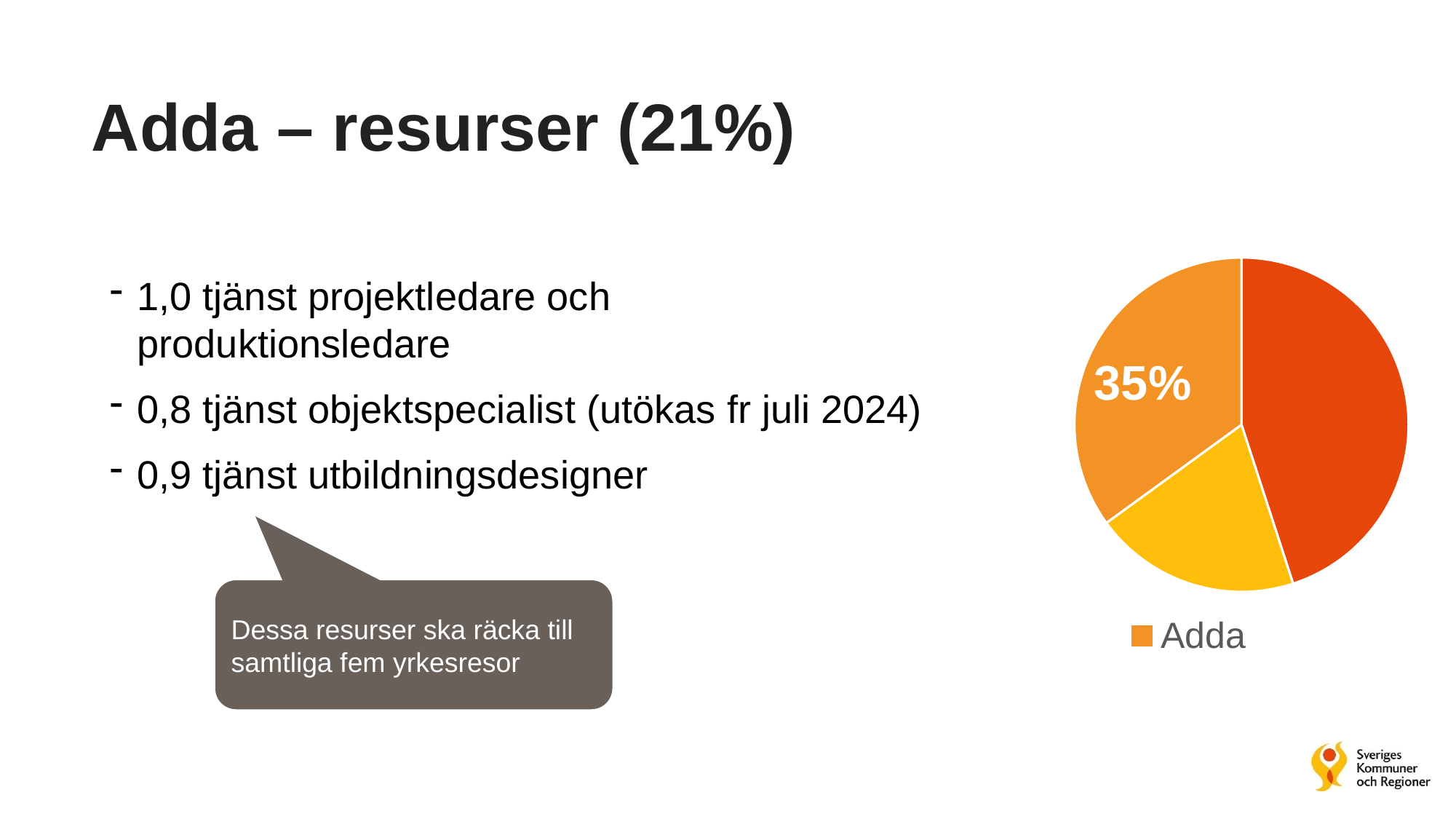
What is the only entry shown in the pie chart's legend? Adda What share of the pie does the Adda slice represent? 35% Is the red slice of the pie chart larger or smaller than the Adda slice? larger What percentage is printed on the Adda slice of the pie chart? 35% How many slices does the pie chart have? 3 Which slice of the pie chart is the smallest: the red, the yellow or the orange (Adda) slice? the yellow slice What kind of chart is shown on the slide? pie chart Which slice of the pie chart is the largest: the red, the yellow or the orange (Adda) slice? the red slice What colour is the slice labelled 35% in the pie chart? orange How many entries does the pie chart's legend list? 1